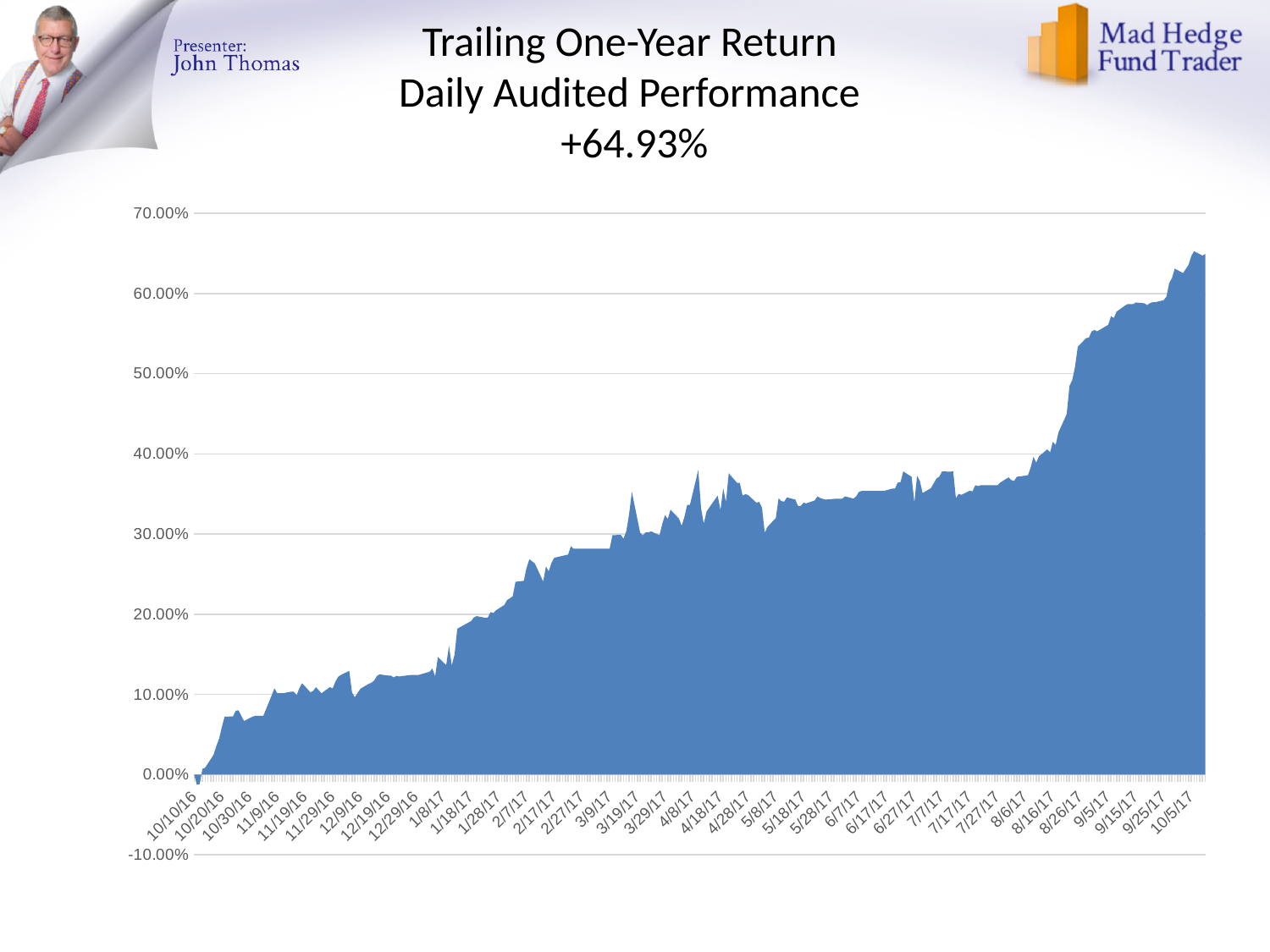
What is the highest value shown on the vertical axis? 70.00% Is the value at 10/5/17 greater or less than 60.00%? greater Is the value at 11/9/16 greater or less than 20.00%? less Is the value at 7/7/17 greater or less than 30.00%? greater Do the values generally rise or fall from 10/10/16 to 10/5/17? Rise What kind of chart is shown on the slide? Area chart Which is larger, the value at 8/26/17 or the value at 1/8/17? 8/26/17 What trailing one-year return figure is printed in the slide title? +64.93% Which is larger, the value at 10/5/17 or the value at 10/10/16? 10/5/17